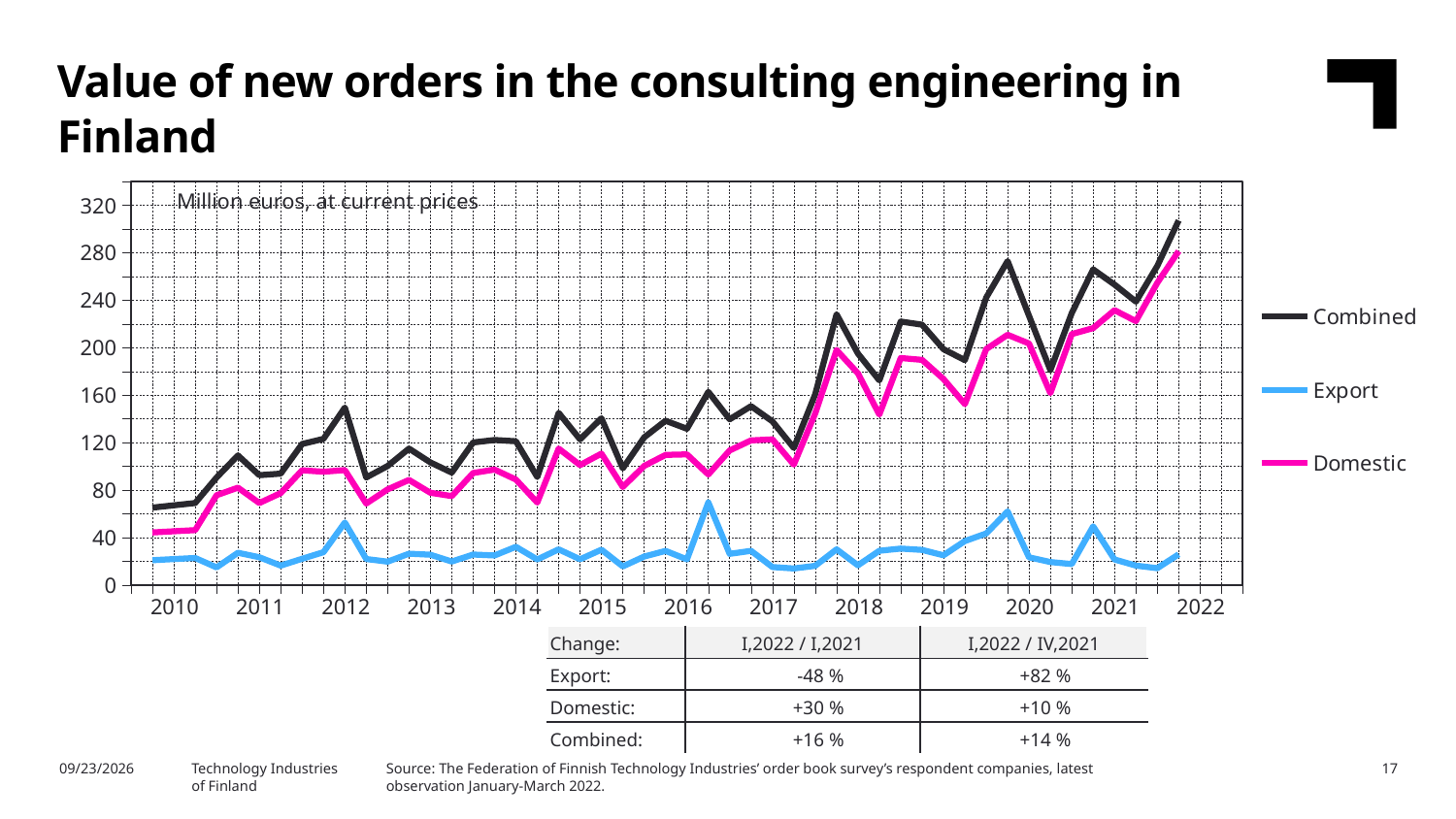
How many series does the chart legend list? 3 Which series has the highest value at the start of 2022? Combined What kind of chart is shown on the slide? line chart What unit is stated for the values in the chart? Million euros, at current prices What are the three series named in the chart legend? Combined, Export, Domestic Is the peak value of the Export series in 2016 greater or less than 40? greater Is the value of the Combined series at the start of 2022 greater or less than 280? greater Which series has the lowest values throughout the chart? Export Is the value of the Combined series at the start of 2010 greater or less than 80? less Does the Combined series overall rise or fall from 2010 to 2022? rise According to the table below the chart, what is the Export change for I,2022 / I,2021? -48 %